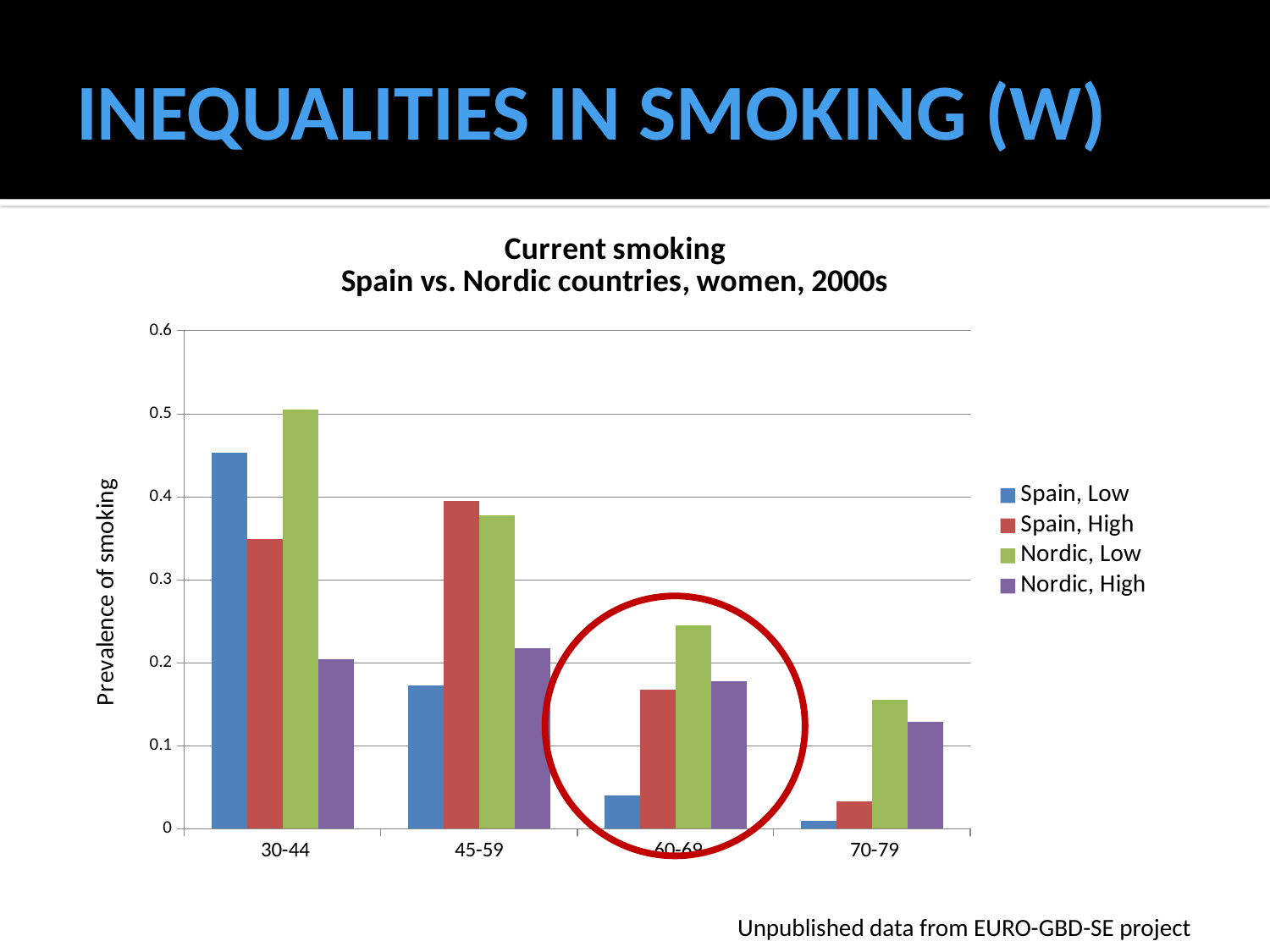
How many age groups are shown on the x axis? 4 In the 30-44 age group, which is larger: Spain, Low or Spain, High? Spain, Low What kind of chart is shown on the slide? bar chart Which age group has the lowest value for Spain, Low? 70-79 Do the values for Spain, Low rise or fall as age group increases along the x axis? fall What is the label of the y axis? Prevalence of smoking How many series does the legend list? 4 Is the value for Spain, Low in the 45-59 age group greater or less than 0.2? less In the 45-59 age group, which is larger: Spain, High or Spain, Low? Spain, High Is the value for Nordic, Low in the 30-44 age group greater or less than 0.4? greater Is the value for Nordic, High in the 70-79 age group greater or less than 0.1? greater Which age group has the highest value for Nordic, Low? 30-44